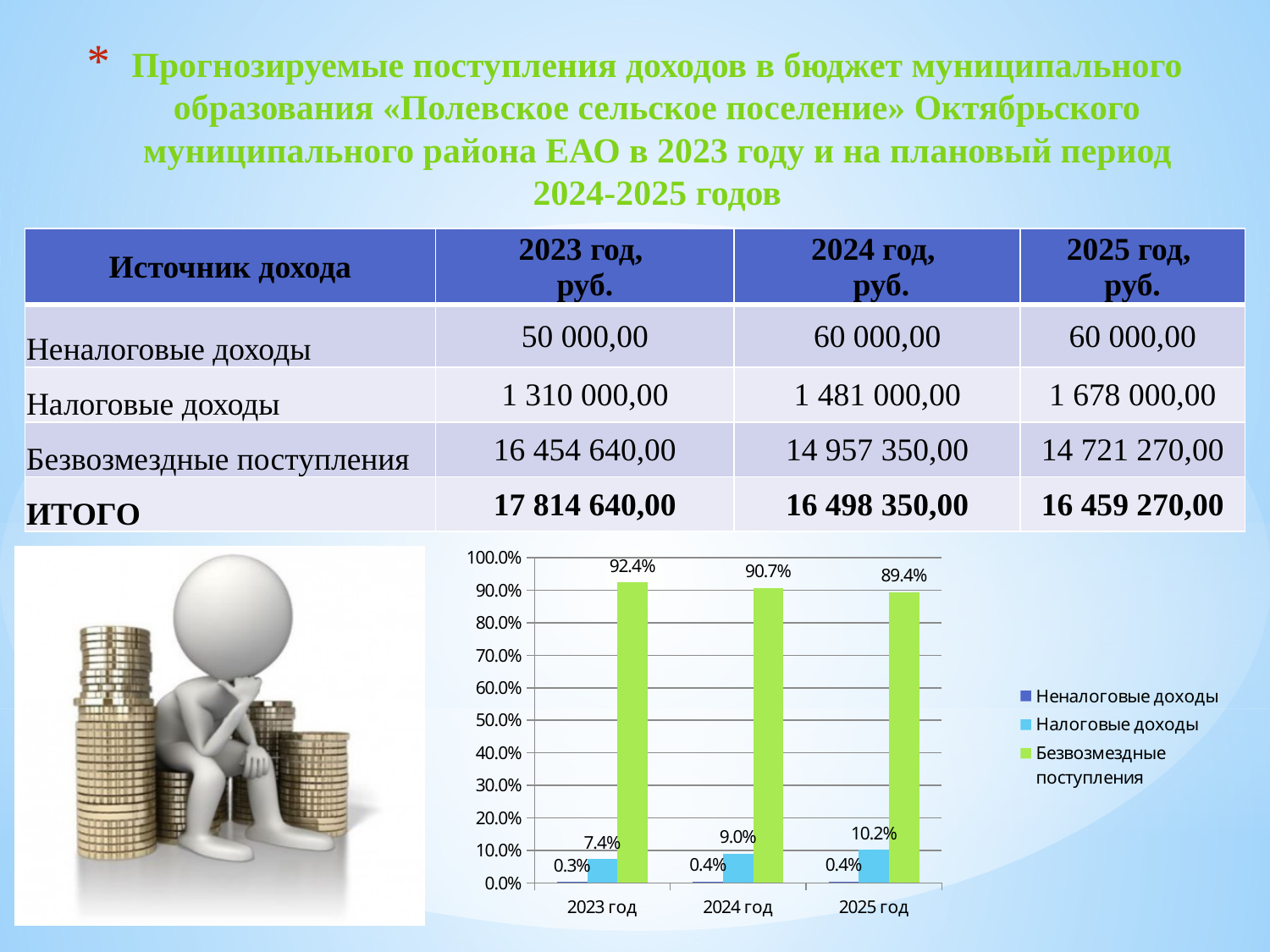
Which series is shown in green in the chart? Безвозмездные поступления How many categories are shown on the x axis of the chart? 3 What is the value for Налоговые доходы in 2025 год? 10.2% What is the difference between the Безвозмездные поступления values for 2023 год and 2025 год? 3.0% Which is larger: Налоговые доходы in 2024 год or Налоговые доходы in 2025 год? 2025 год In which year is the value for Налоговые доходы the lowest? 2023 год What type of chart is shown on the slide? bar chart Does the value for Безвозмездные поступления rise or fall from 2023 год to 2025 год? fall How many series does the chart legend list? 3 What is the value for Безвозмездные поступления in 2023 год? 92.4% What is the value for Неналоговые доходы in 2024 год? 0.4% In which year is the value for Безвозмездные поступления the highest? 2023 год